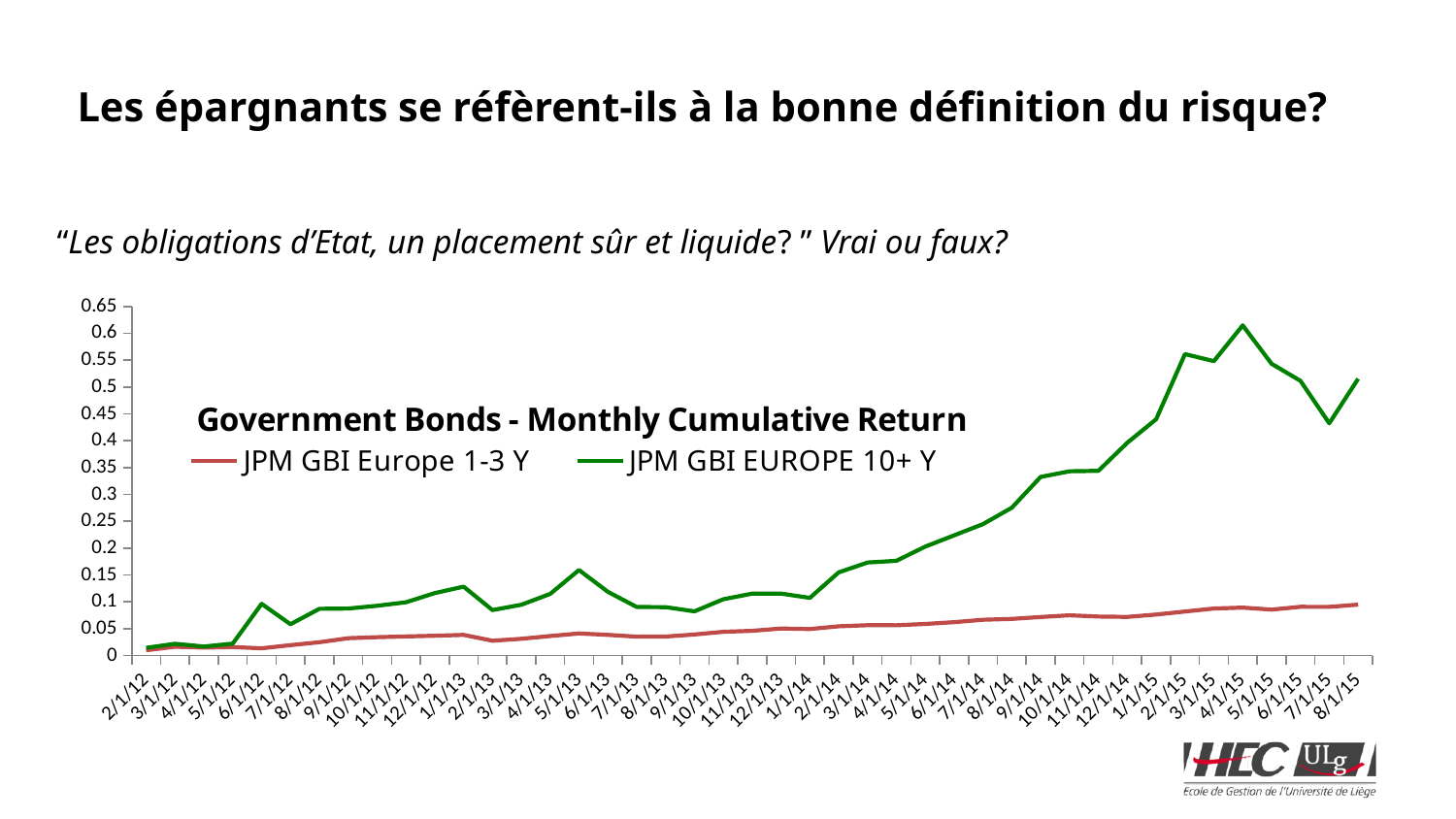
Is the value of JPM GBI EUROPE 10+ Y at 9/1/14 greater or less than 0.3? greater At 8/1/15, which series has the higher value, JPM GBI Europe 1-3 Y or JPM GBI EUROPE 10+ Y? JPM GBI EUROPE 10+ Y Is the value of JPM GBI EUROPE 10+ Y at 4/1/15 greater or less than 0.55? greater Does the JPM GBI Europe 1-3 Y series generally rise or fall from 2/1/12 to 8/1/15? rise Which series is drawn in green in the chart? JPM GBI EUROPE 10+ Y Is the value of JPM GBI Europe 1-3 Y at 8/1/15 greater or less than 0.1? less At which date does the JPM GBI EUROPE 10+ Y series reach its peak? 4/1/15 What kind of chart is shown on the slide? line chart Which series reaches the highest value in the chart? JPM GBI EUROPE 10+ Y How many series does the legend of the chart list? 2 What is the title of the chart? Government Bonds - Monthly Cumulative Return